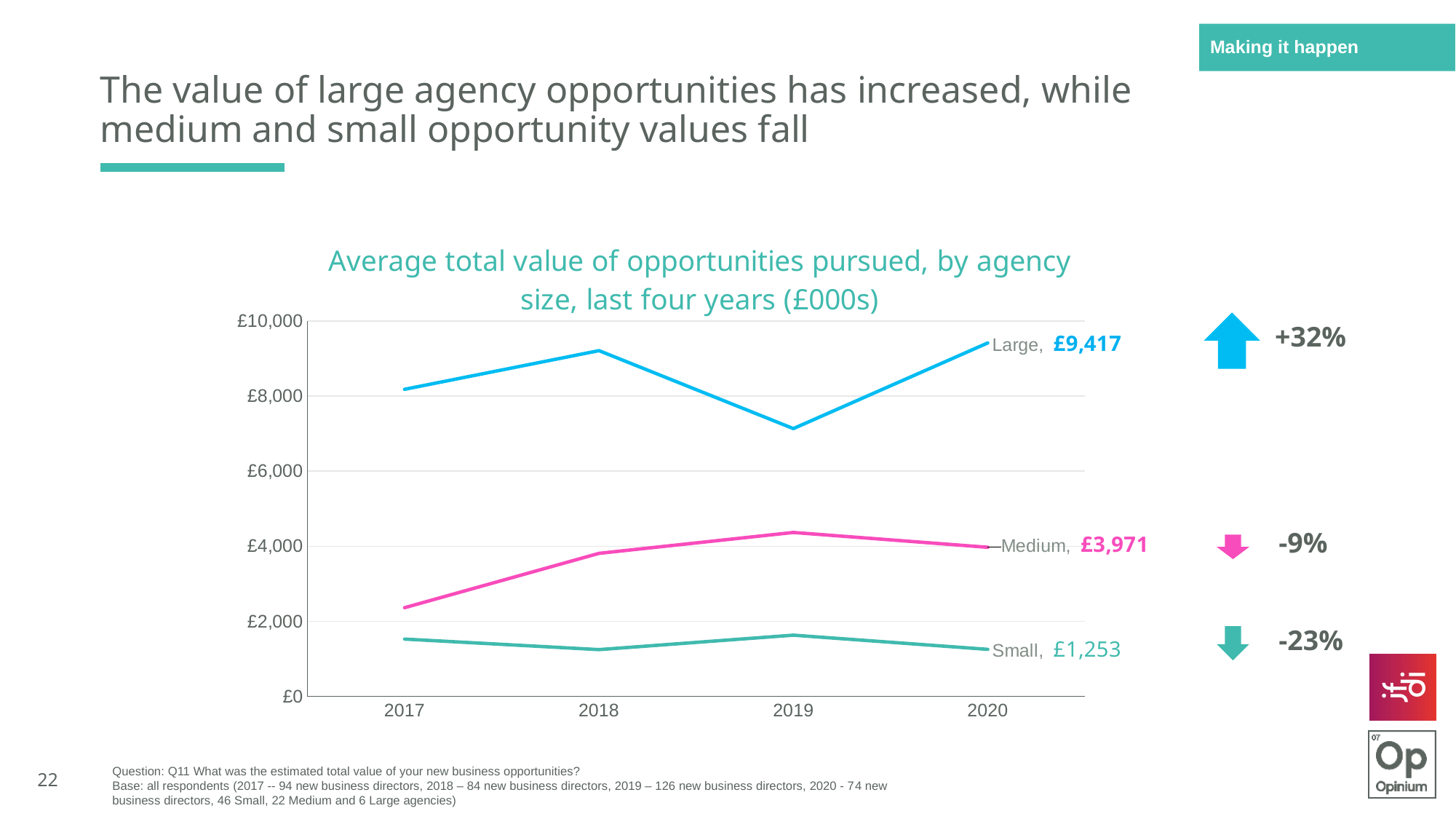
What is the value for Large agencies in 2020? £9,417 How many years are shown on the x axis? 4 Which agency size has the highest value in 2020? Large Which is larger for Large agencies: the 2018 value or the 2019 value? 2018 What kind of chart is shown on the slide? Line chart Is the value for Medium agencies in 2017 greater or less than £4,000? less How many series (agency sizes) are plotted on the chart? 3 What is the value for Medium agencies in 2020? £3,971 Is the value for Large agencies in 2019 greater or less than £8,000? less What is the value for Small agencies in 2020? £1,253 Which agency size has the lowest value in 2020? Small What is the difference between the Large and Medium values in 2020? £5,446